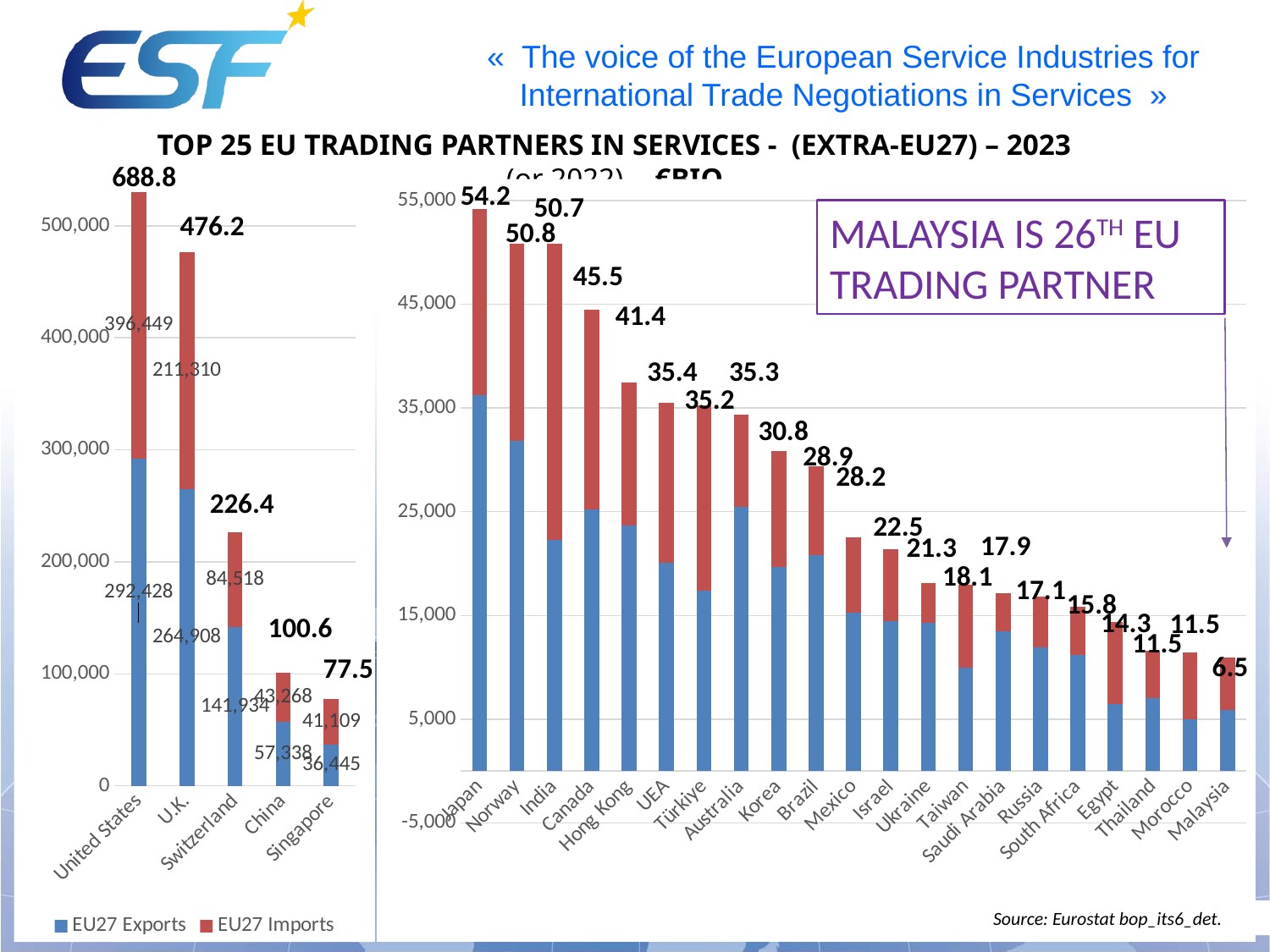
On the left chart, how many series does the legend list? 2 On the left chart, what is the difference between EU27 Imports and EU27 Exports for United States? 104,021 On the right chart, which country has the highest total? Japan On the left chart, which is larger for U.K., EU27 Exports or EU27 Imports? EU27 Exports On the left chart, how many countries are shown? 5 On the right chart, what is the total labelled above the Canada bar? 45.5 On the right chart, is the EU27 Exports value for Norway greater or less than 35,000? less On the right chart, which country has the lowest total? Malaysia What kind of chart is the right chart? Stacked bar chart On the left chart, what is the EU27 Imports value for United States? 396,449 On the left chart, what is the total labelled above the United States bar? 688.8 On the left chart, what is the EU27 Exports value for United States? 292,428